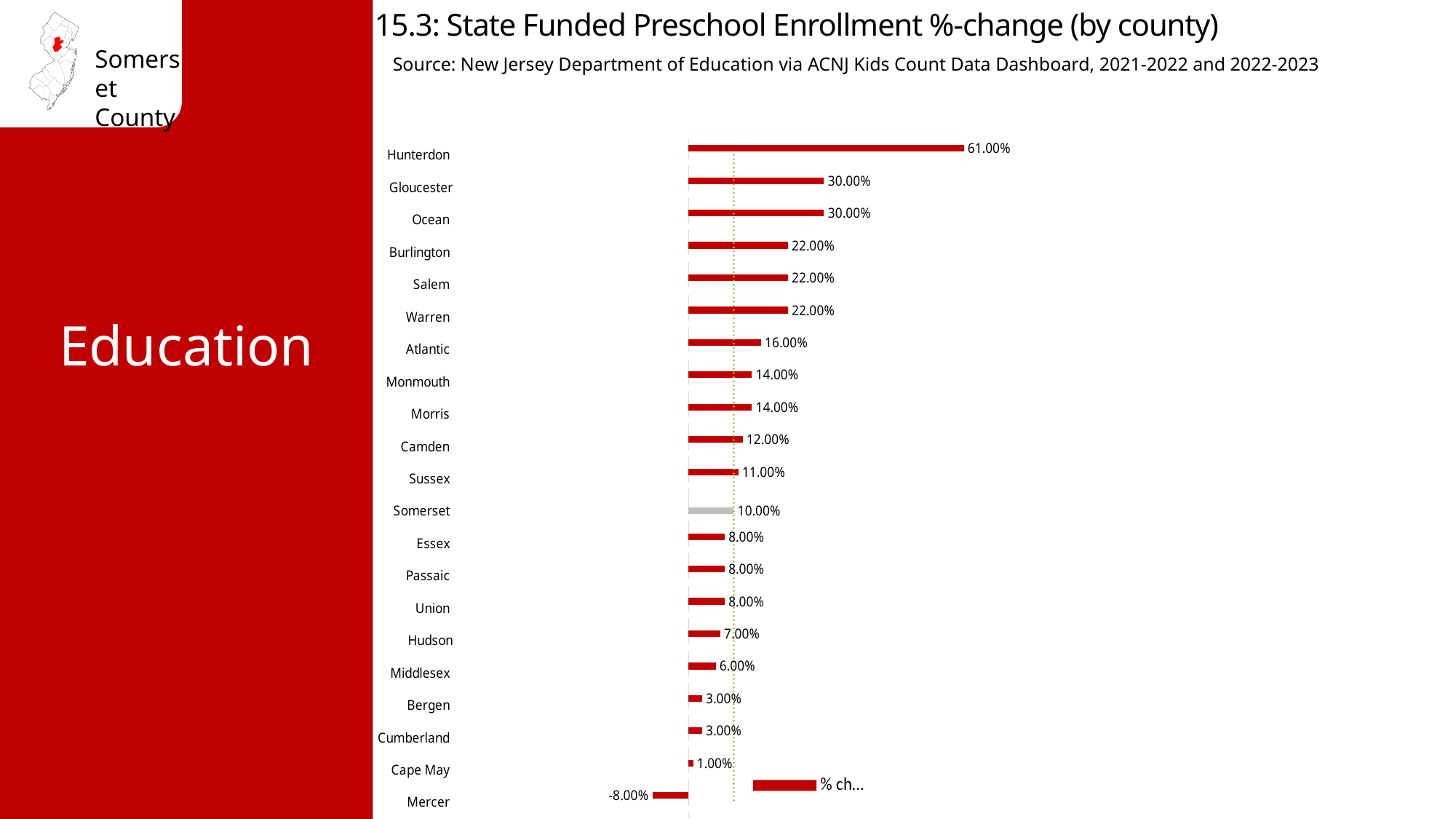
What kind of chart is shown on the slide? Bar chart Which county's bar is drawn in grey rather than red? Somerset What is the difference between the values for Hunterdon and Gloucester? 31.00% What is the value shown for Mercer? -8.00% What is the value shown for Somerset? 10.00% Which county has the lowest %-change? Mercer What is the state funded preschool enrollment %-change for Hunterdon? 61.00% What is the difference between the values for Somerset and Mercer? 18.00% Which has a larger value, Atlantic or Camden? Atlantic How many counties are shown on the chart? 21 Which county has the highest %-change? Hunterdon What is the value shown for Cape May? 1.00%